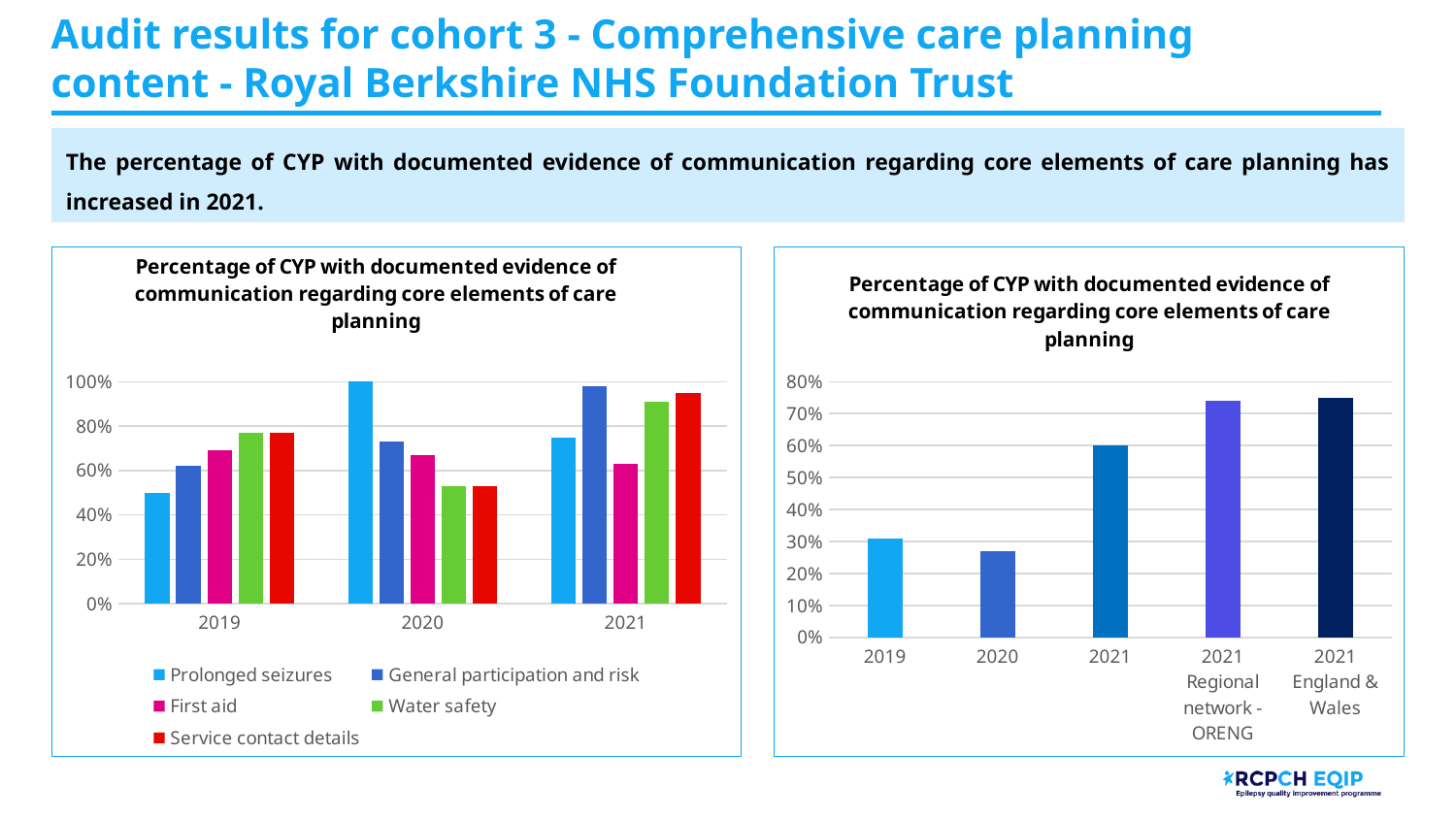
In the left chart, which is larger in 2021: General participation and risk or First aid? General participation and risk How many bars are shown in the right chart? 5 In the right chart, is the value for 2020 greater or less than 30%? less In the left chart, is the value for General participation and risk in 2021 greater or less than 80%? greater In the right chart, is the value for 2021 Regional network - ORENG greater or less than 70%? greater In the right chart, which category has the lowest value? 2020 In the left chart, which series has the highest value in 2020? Prolonged seizures What kind of chart is the right chart? Bar chart How many series does the legend of the left chart list? 5 In the left chart, what is the value for Prolonged seizures in 2020? 100% In the right chart, what is the value for 2021? 60%